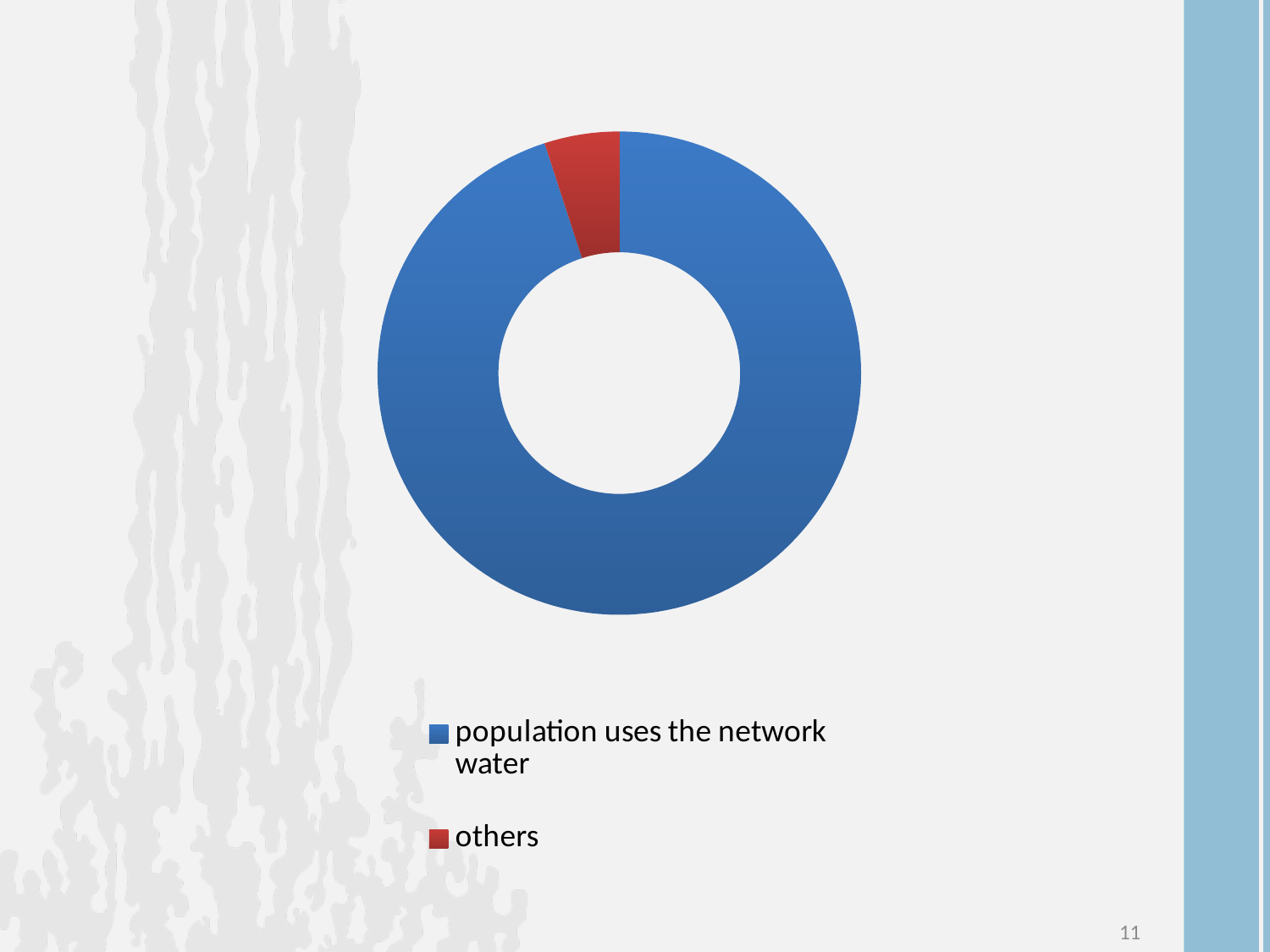
What colour represents 'population uses the network water' in the chart? blue Which category has the smallest share of the chart? others Which is larger: the share for 'population uses the network water' or the share for 'others'? population uses the network water How many categories does the legend list? 2 Which category has the largest share of the chart? population uses the network water What colour represents 'others' in the chart? red What kind of chart is shown on the slide? doughnut chart